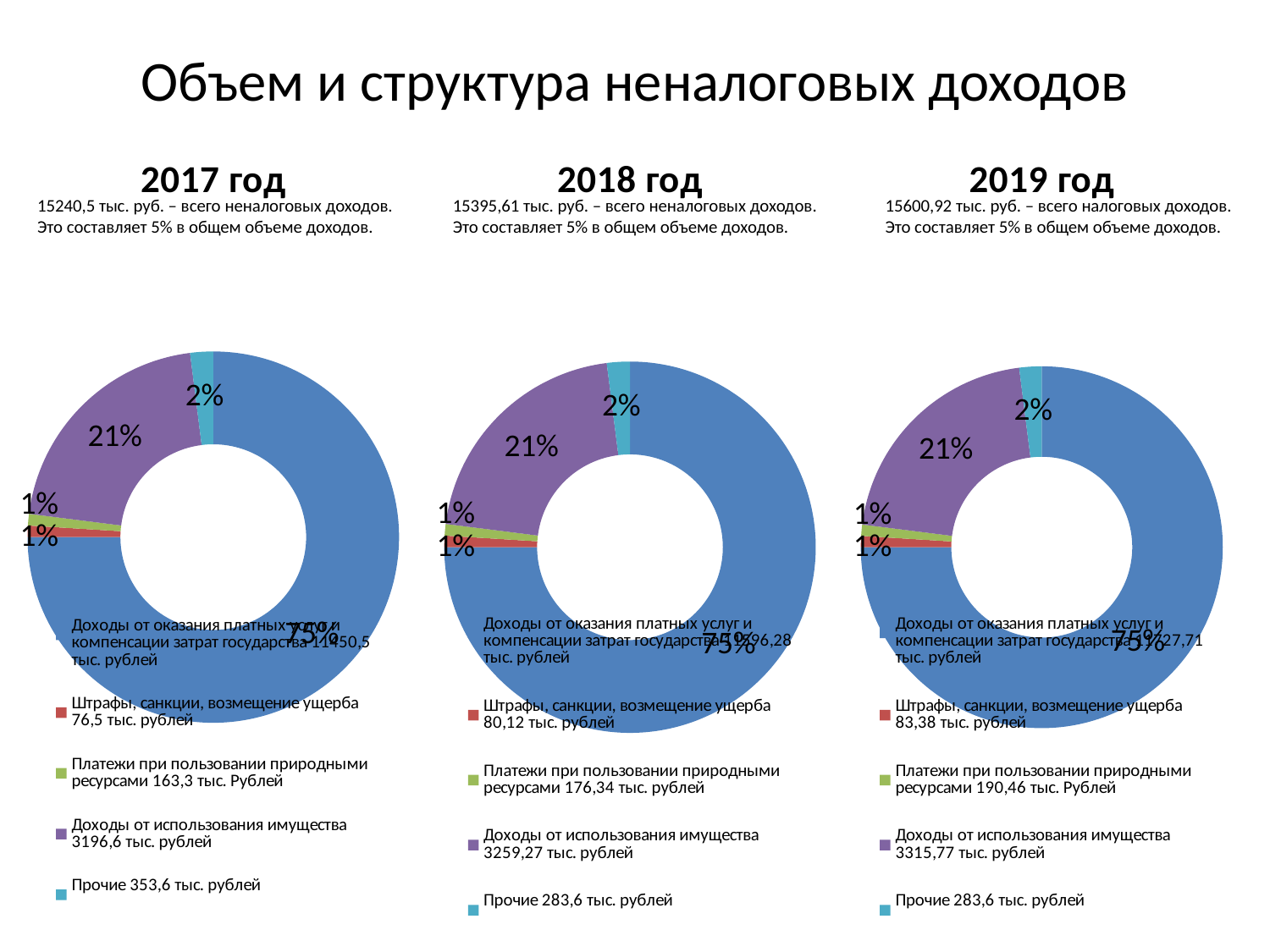
According to the legend of the 2018 год chart, what is the value for Платежи при пользовании природными ресурсами? 176,34 тыс. рублей What is the difference between Прочие in the 2017 год chart (353,6) and in the 2018 год chart (283,6)? 70 тыс. рублей According to the legend of the 2019 год chart, what is the value for Доходы от использования имущества? 3315,77 тыс. рублей Which is larger: Штрафы, санкции, возмещение ущерба in the 2018 год chart or in the 2019 год chart? 2019 год (83,38 тыс. рублей) According to the legend of the 2017 год chart, what is the value for Штрафы, санкции, возмещение ущерба? 76,5 тыс. рублей How many categories does the legend of the 2019 год chart list? 5 In the 2017 год chart, which category has the largest slice? Доходы от оказания платных услуг и компенсации затрат государства In the 2017 год chart, what share does the largest slice (Доходы от оказания платных услуг и компенсации затрат государства) have? 75% In the 2018 год chart, what share does Доходы от использования имущества have? 21% In the 2019 год chart, what share does the Прочие slice have? 2% What is the difference between Доходы от использования имущества in the 2019 год chart (3315,77) and in the 2018 год chart (3259,27)? 56,5 тыс. рублей What kind of chart is used for the 2017 год chart? Doughnut (pie) chart